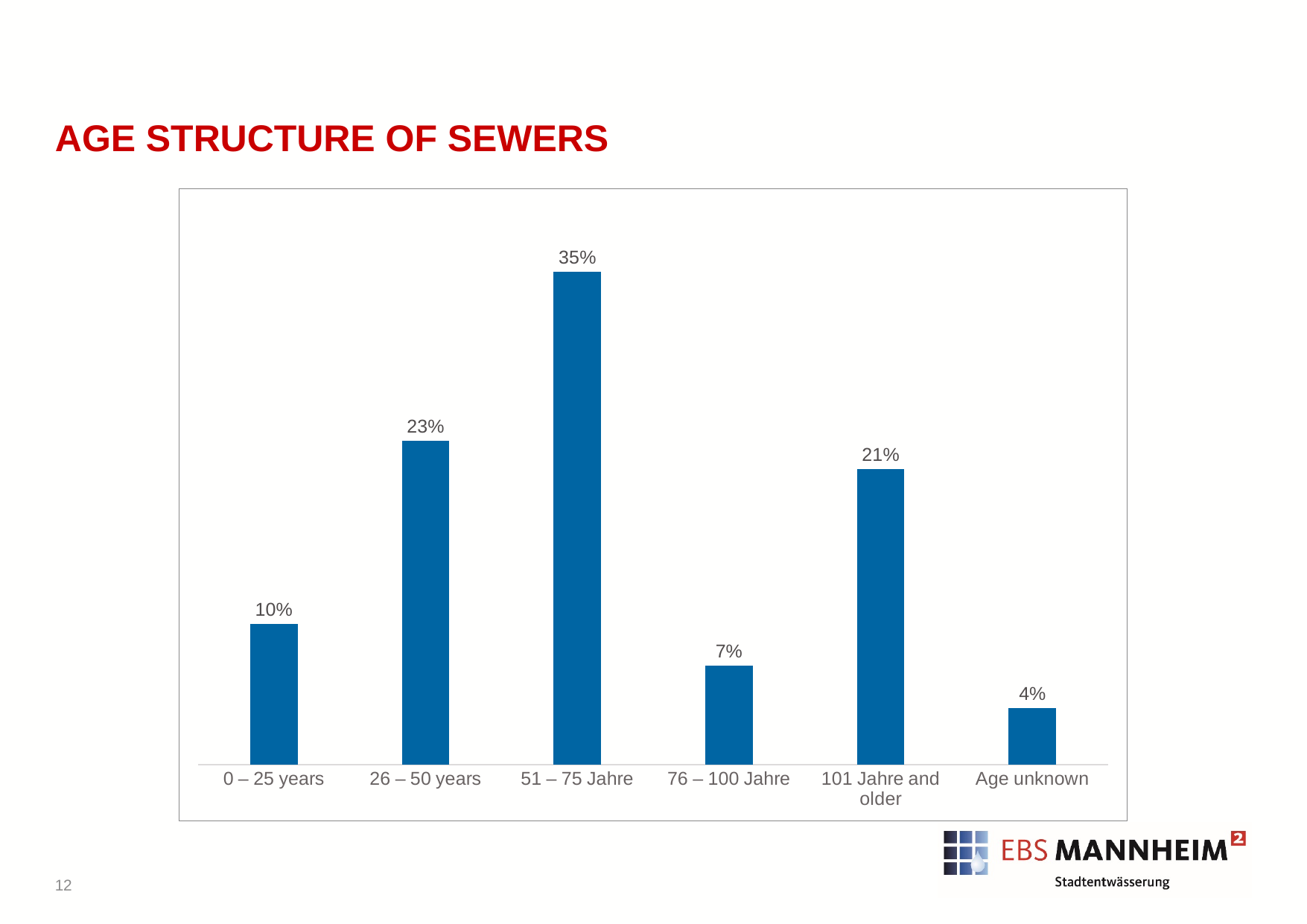
Which category has the lowest percentage? Age unknown How many age categories are shown in the chart? 6 What type of chart is shown on the slide? Bar chart What is the value shown for the 51 – 75 Jahre category? 35% What is the difference between the 0 – 25 years and 76 – 100 Jahre values? 3% Which is larger, the value for 26 – 50 years or for 101 Jahre and older? 26 – 50 years What is the value for the Age unknown category? 4% What percentage is shown for 101 Jahre and older? 21% What percentage of sewers are 0 – 25 years old? 10% What is the difference between the 51 – 75 Jahre and 26 – 50 years values? 12% What is the title of the slide? AGE STRUCTURE OF SEWERS Which age category has the highest percentage? 51 – 75 Jahre